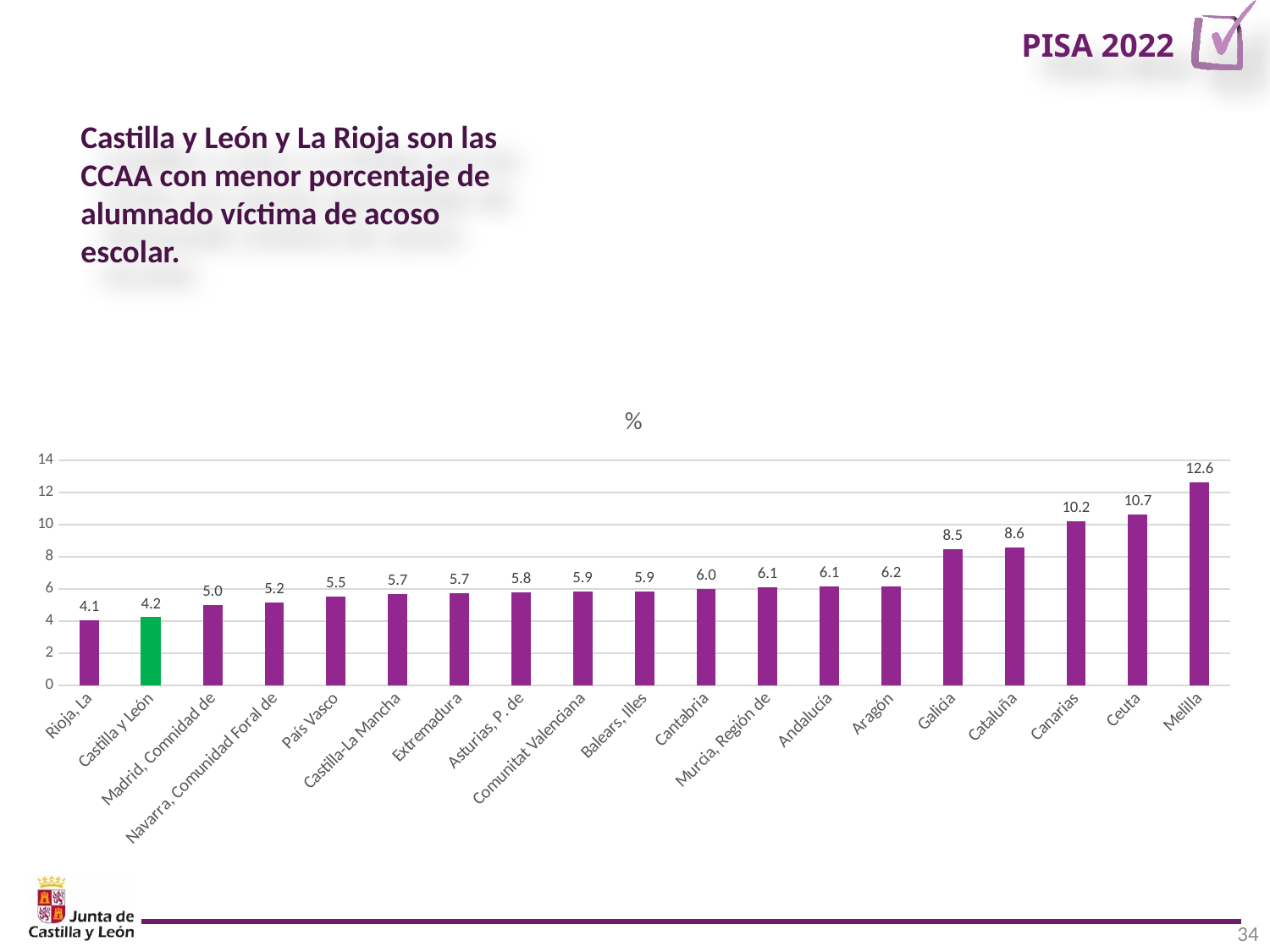
What is the value for Melilla? 12.6 What is the difference between the values for Ceuta and Canarias? 0.5 What is the value for Castilla y León? 4.2 What is the value for Galicia? 8.5 Which category has the highest value? Melilla What is the value for Cantabria? 6.0 Which category has the lowest value? Rioja, La What kind of chart is shown on the slide? Bar chart Which is larger, the value for Cataluña or the value for Aragón? Cataluña How many categories are shown on the x axis? 19 What is the difference between the values for Melilla and Rioja, La? 8.5 Which bar is coloured green rather than purple? Castilla y León